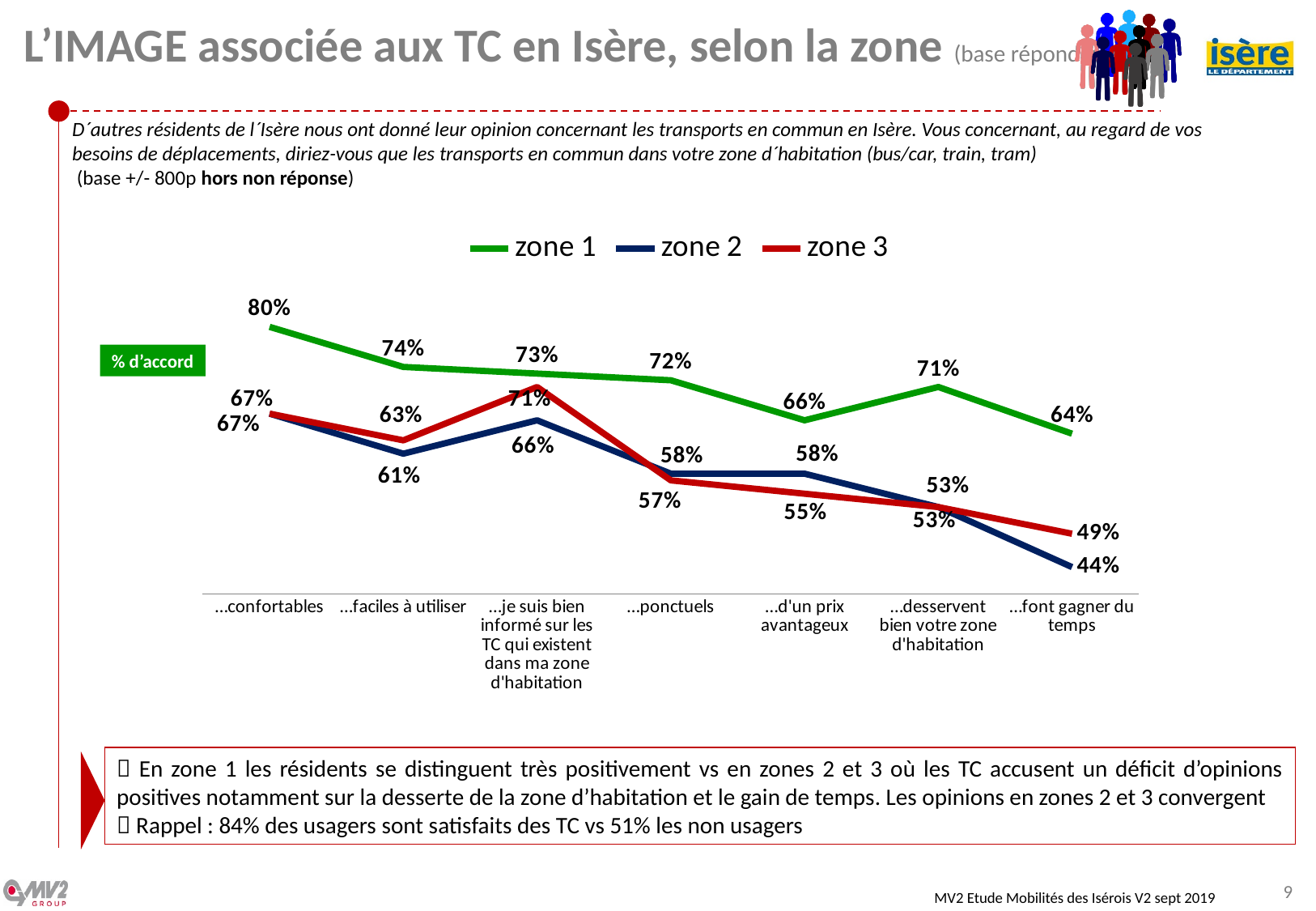
What is the difference between zone 1 and zone 2 for "…font gagner du temps"? 20 percentage points What is the value for zone 2 for "…font gagner du temps"? 44% What is the value for zone 1 for "…desservent bien votre zone d'habitation"? 71% What is the value for zone 1 for "…confortables"? 80% For "…faciles à utiliser", which is larger: zone 1 or zone 3? zone 1 For which category is the zone 2 value lowest? …font gagner du temps Do the zone 2 values generally rise or fall from left to right along the x axis? fall For which category is the zone 1 value highest? …confortables How many series does the legend list? 3 What is the value for zone 3 for "…je suis bien informé sur les TC qui existent dans ma zone d'habitation"? 71% What kind of chart is shown on the slide? line chart How many categories are plotted along the x axis? 7